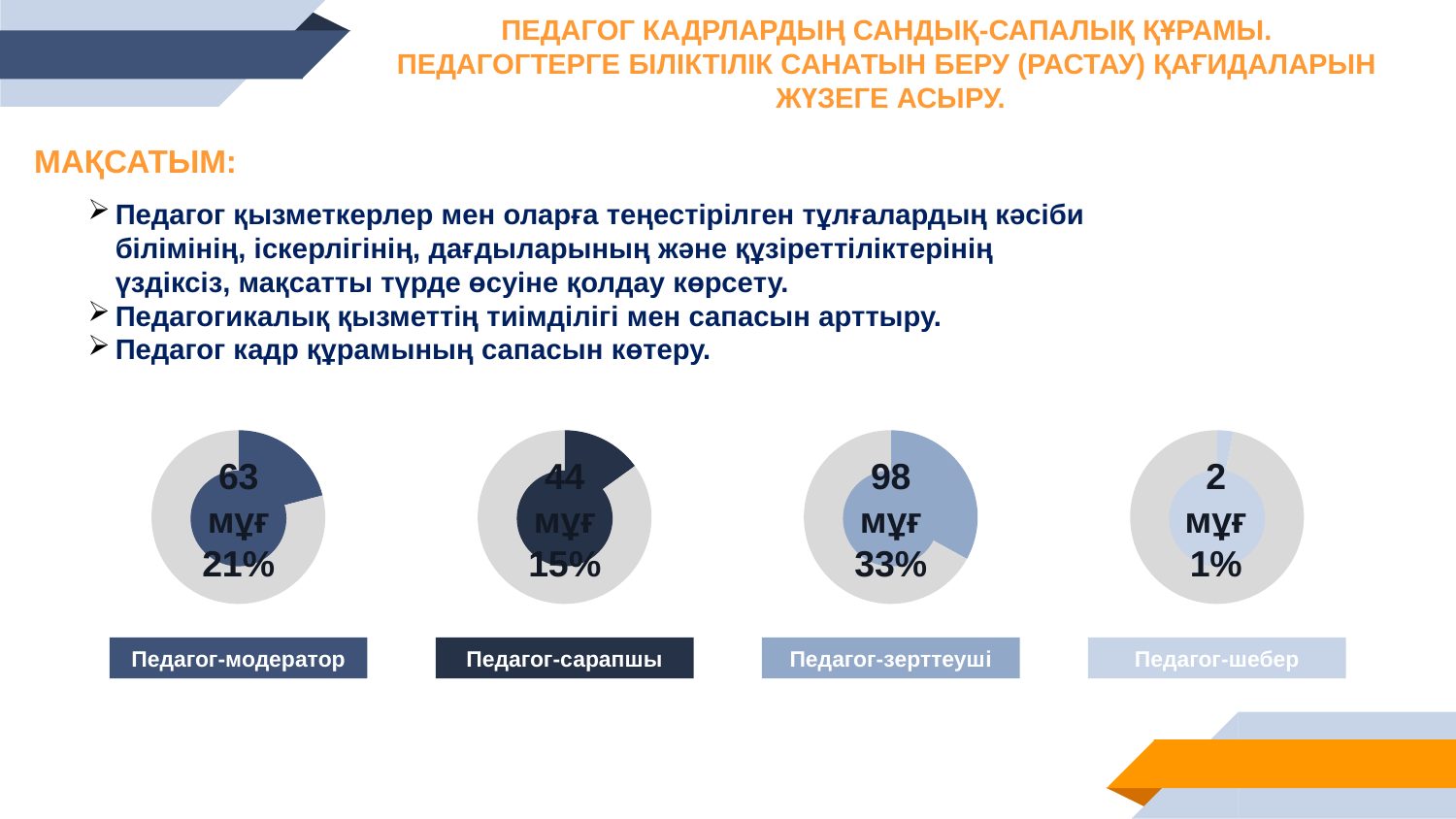
What is the difference in the number of teachers between the Педагог-зерттеуші chart and the Педагог-модератор chart? 35 How many donut charts are shown on the slide? 4 What percentage is shown in the donut chart labelled Педагог-шебер? 1% How many teachers are shown in the donut chart labelled Педагог-зерттеуші? 98 мұғ What is the difference in percentage between the Педагог-модератор chart and the Педагог-сарапшы chart? 6% How many teachers are shown in the donut chart labelled Педагог-модератор? 63 мұғ Which of the four donut charts shows the highest number of teachers? Педагог-зерттеуші Which shows a larger number of teachers, the Педагог-модератор chart or the Педагог-сарапшы chart? Педагог-модератор What percentage is shown in the donut chart labelled Педагог-сарапшы? 15% What type of chart is used to show the Педагог-шебер value? Donut (pie) chart Which of the four donut charts shows the lowest percentage? Педагог-шебер What is the total number of teachers across all four donut charts? 207